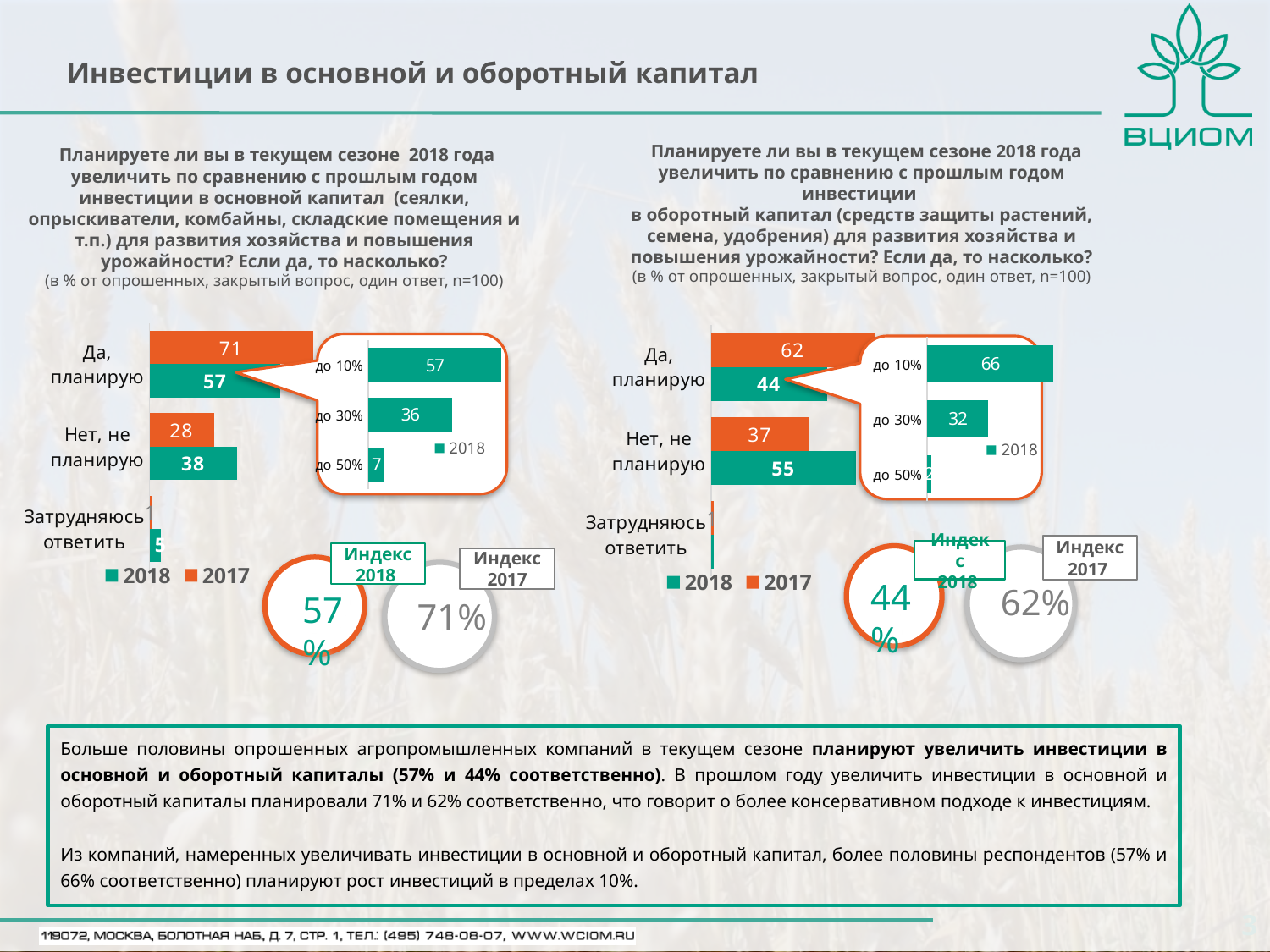
In the callout chart on the right (working capital), which category has the highest value? до 10% On the left chart (investments in fixed capital), what is the 2018 value for 'Нет, не планирую'? 38 On the right chart (investments in working capital), what is the 2018 value for 'Да, планирую'? 44 In the callout chart on the left (fixed capital), what is the value for 'до 10%'? 57 On the right chart (investments in working capital), which is larger for 'Нет, не планирую': the 2018 value or the 2017 value? 2018 On the left chart (investments in fixed capital), what is the 2018 value for 'Да, планирую'? 57 On the right chart (investments in working capital), what is the 2017 value for 'Нет, не планирую'? 37 How many series does the legend of the left chart list? 2 On the left chart (investments in fixed capital), what is the 2017 value for 'Да, планирую'? 71 In the callout chart on the right (working capital), what is the value for 'до 30%'? 32 On the left chart (investments in fixed capital), what is the difference between the 2017 and 2018 values for 'Да, планирую'? 14 What type of chart is used for the left chart (investments in fixed capital)? Bar chart